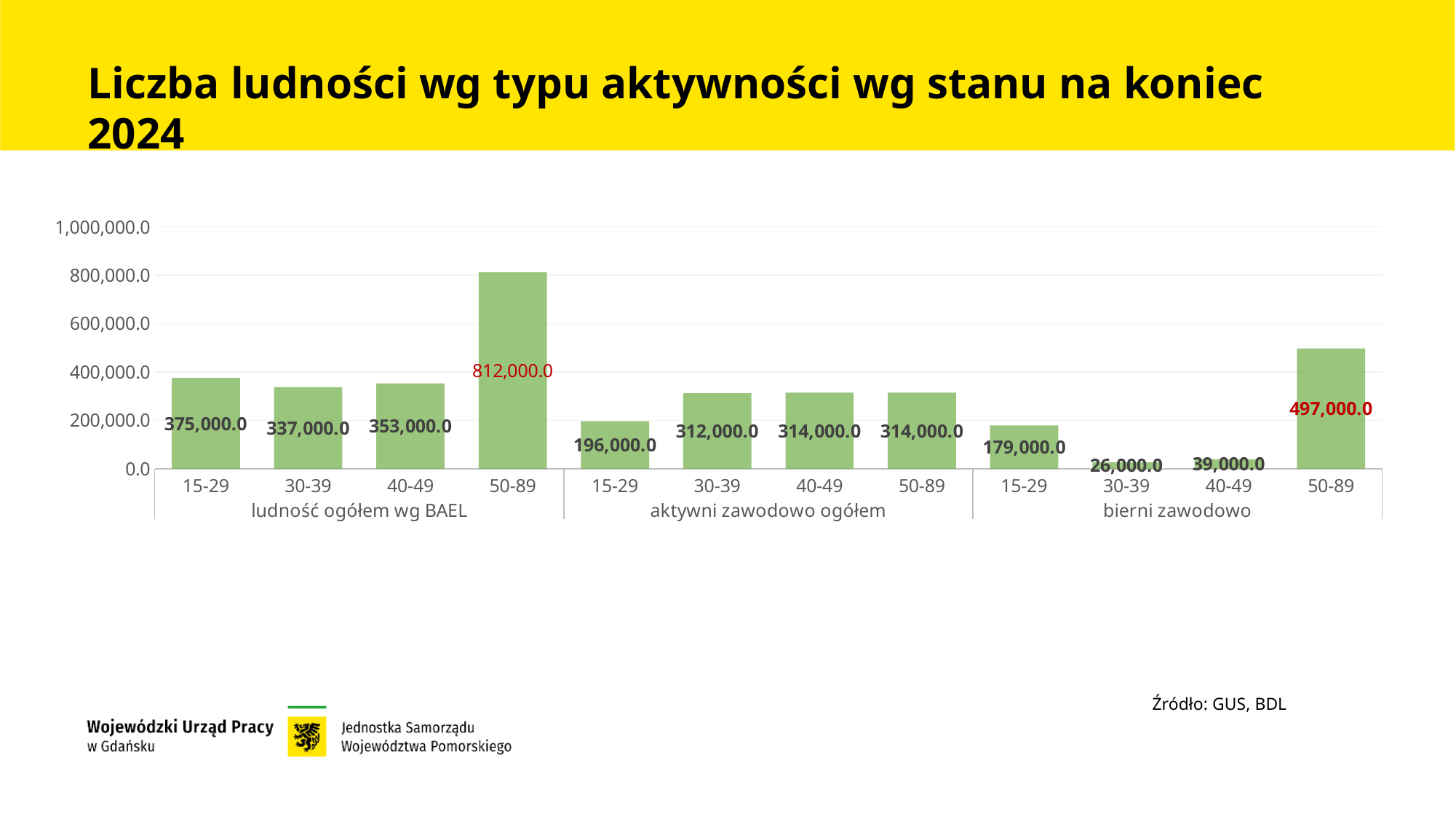
Which is larger: the 15-29 value in 'ludność ogółem wg BAEL' or the 15-29 value in 'aktywni zawodowo ogółem'? 15-29 in ludność ogółem wg BAEL Is the value for 50-89 in 'bierni zawodowo' greater or less than 400,000.0? greater How many category groups are shown along the x axis? 3 Which bar has the highest value on the chart? 50-89 in ludność ogółem wg BAEL What is the value for the 15-29 age group in the 'aktywni zawodowo ogółem' group? 196,000.0 What is the source cited for the chart data? GUS, BDL What kind of chart is shown on the slide? bar chart What is the value for the 30-39 age group in the 'bierni zawodowo' group? 26,000.0 What is the difference between the 50-89 and 15-29 values in the 'bierni zawodowo' group? 318,000.0 Which bar has the lowest value on the chart? 30-39 in bierni zawodowo What is the value for the 50-89 age group in the 'ludność ogółem wg BAEL' group? 812,000.0 How many bars are plotted on the chart? 12